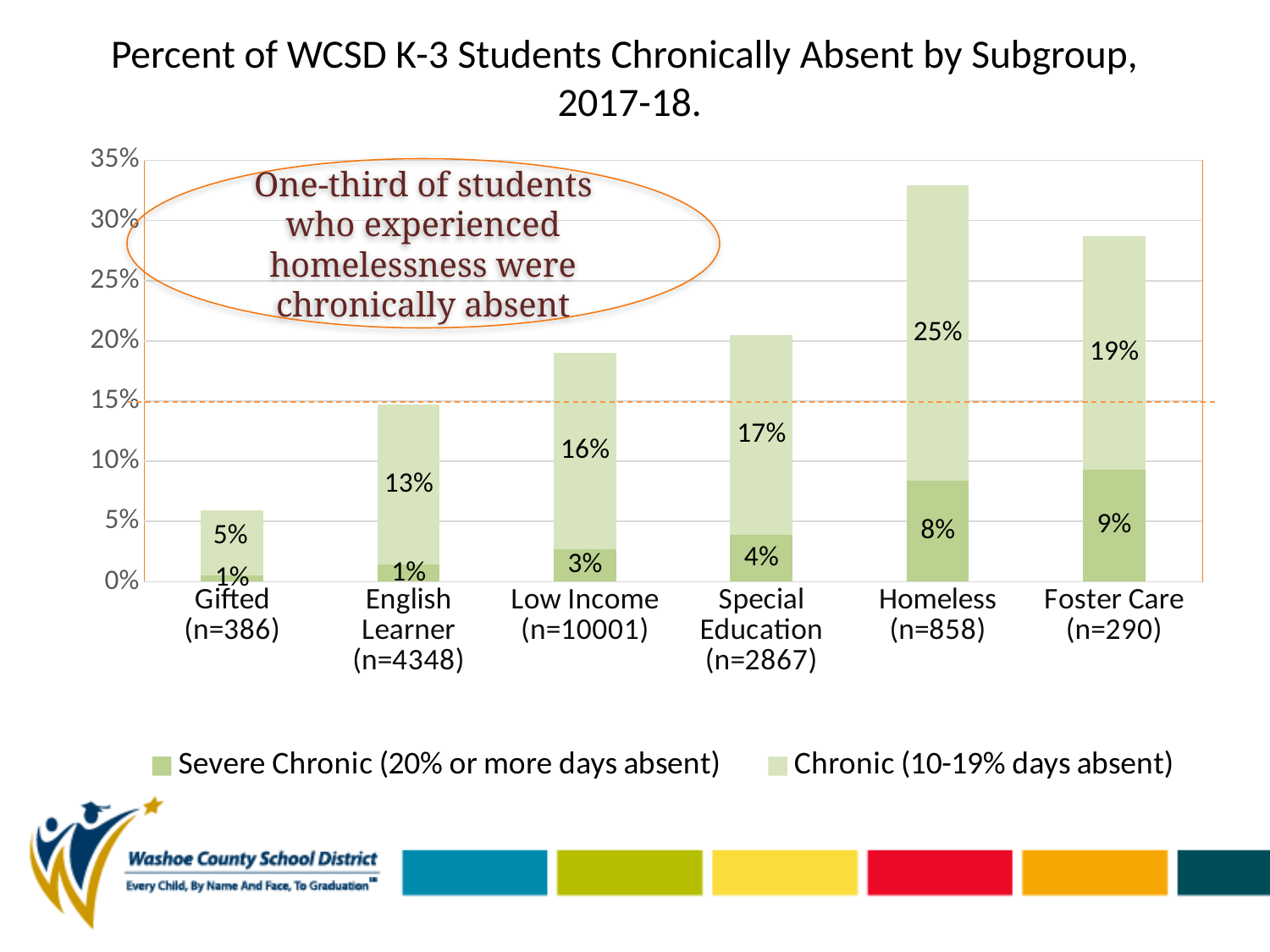
What is the Chronic (10-19% days absent) value for the Homeless subgroup? 25% What is the Severe Chronic (20% or more days absent) value for Foster Care? 9% What is the difference between the Chronic (10-19% days absent) values for Homeless and Foster Care? 6% Which is larger, the Severe Chronic value for Special Education or for Low Income? Special Education What is the total height of the stacked bar for the Homeless subgroup? 33% What is the Chronic (10-19% days absent) value for Low Income students? 16% What kind of chart is shown on the slide? Stacked bar chart How many subgroups are shown on the x axis? 6 How many series does the legend list? 2 What is the total height of the stacked bar for the Gifted subgroup? 6% Which subgroup has the lowest Chronic (10-19% days absent) value? Gifted Which subgroup has the highest Chronic (10-19% days absent) value? Homeless